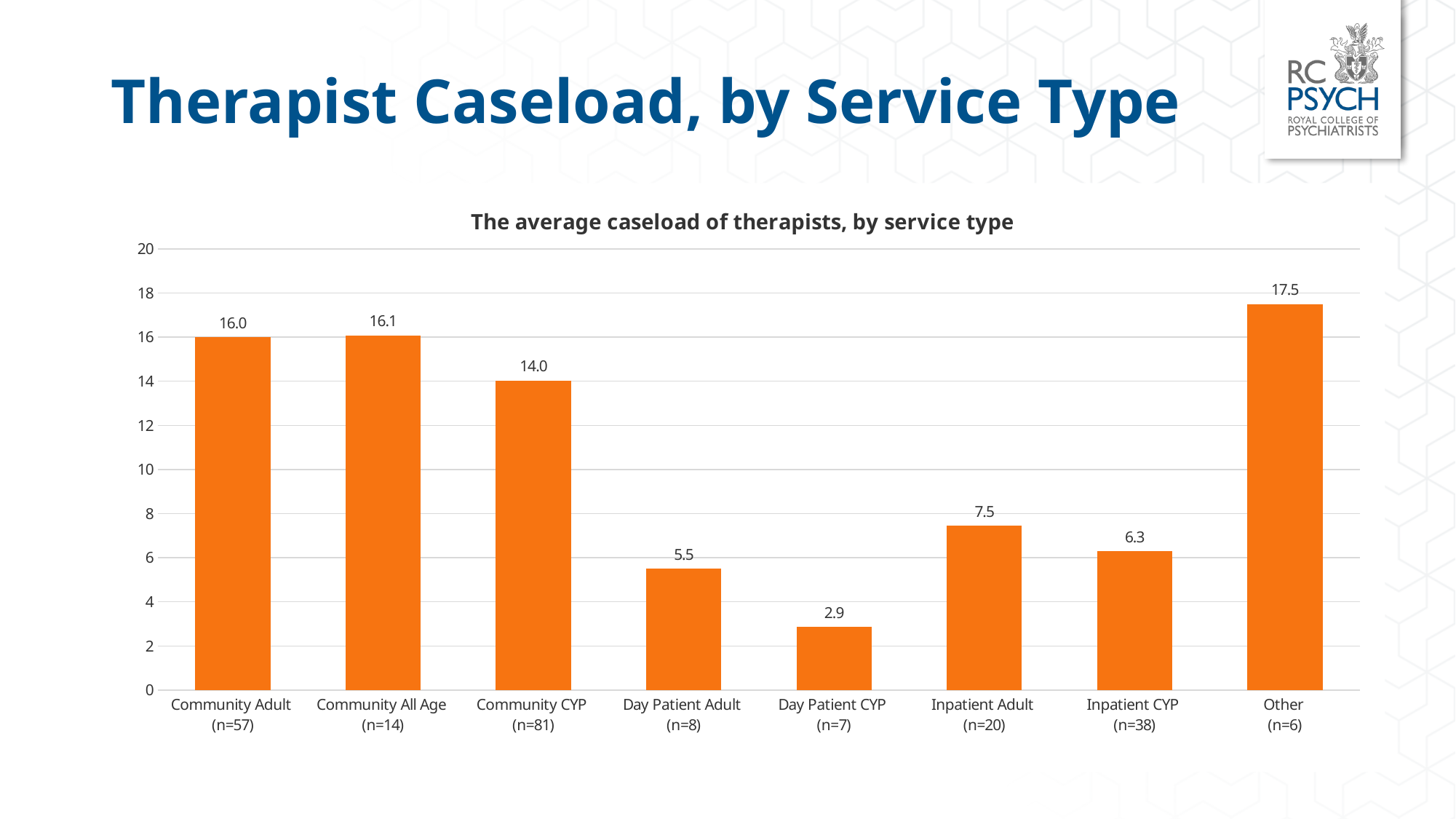
What is the title of the chart? The average caseload of therapists, by service type What kind of chart is shown on the slide? Bar chart Which has a larger average caseload, Day Patient Adult or Inpatient CYP? Inpatient CYP Which service type has the lowest average caseload? Day Patient CYP (n=7) Which service type has the highest average caseload? Other (n=6) What is the average caseload for Inpatient Adult (n=20)? 7.5 What is the difference between the average caseload for Inpatient Adult and Inpatient CYP? 1.2 Is the average caseload for Community All Age greater or less than 14? greater What is the average caseload for Day Patient CYP (n=7)? 2.9 What is the difference between the average caseload for Other and for Community Adult? 1.5 What is the average caseload for Community CYP (n=81)? 14.0 How many service types are shown on the chart? 8